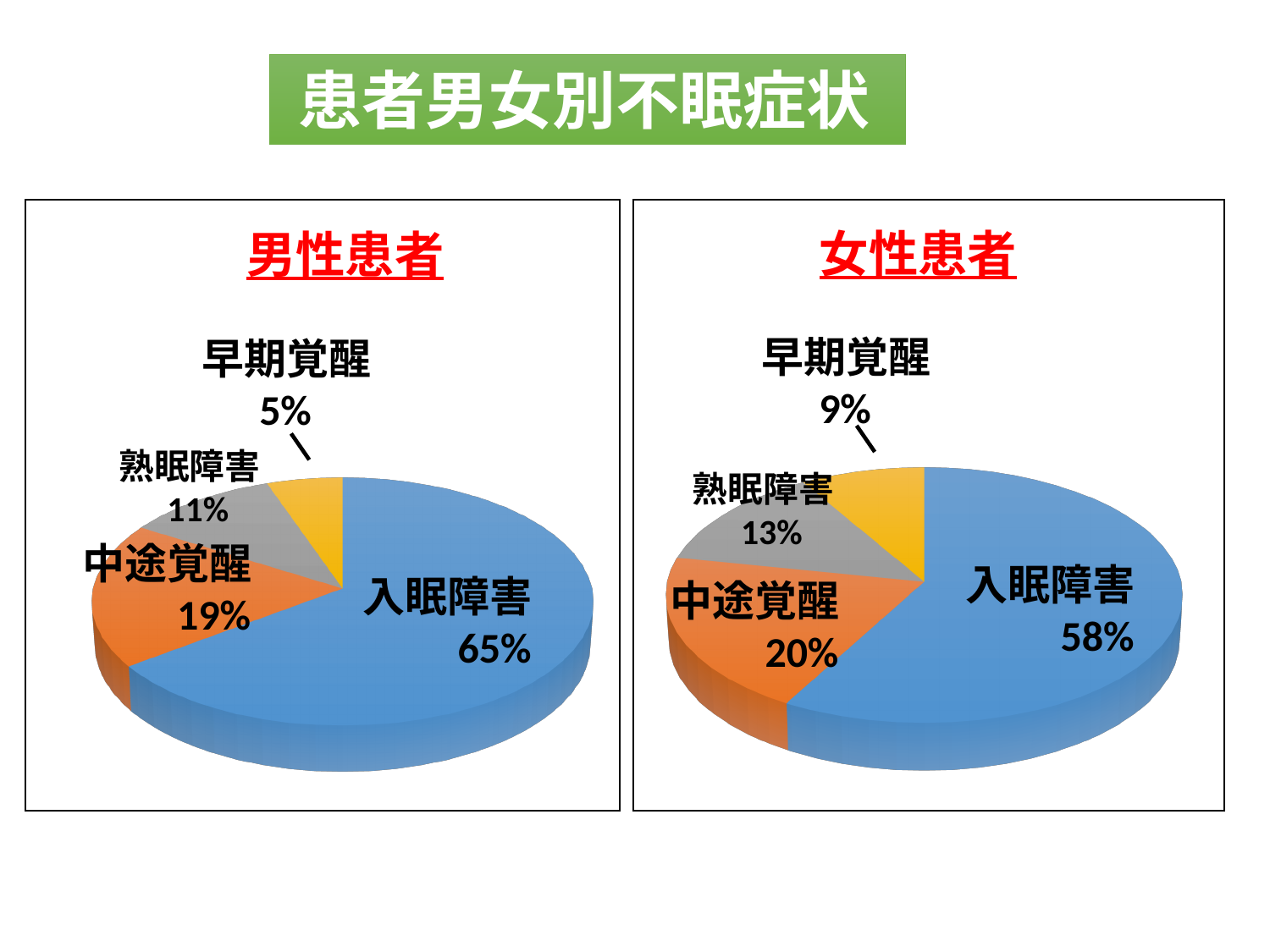
In the 女性患者 pie chart, which category has the largest slice? 入眠障害 In the 男性患者 pie chart, what is the share for 早期覚醒? 5% Which is larger: the share for 早期覚醒 in the 男性患者 chart or in the 女性患者 chart? 女性患者 In the 男性患者 pie chart, what is the share for 入眠障害? 65% In the 男性患者 pie chart, which category has the smallest slice? 早期覚醒 What is the title of the slide? 患者男女別不眠症状 What is the difference between the 入眠障害 share in the 男性患者 chart and in the 女性患者 chart? 7% What kind of chart is used for 男性患者? Pie chart In the 女性患者 pie chart, what is the share for 熟眠障害? 13% How many categories does the 女性患者 pie chart show? 4 In the 女性患者 pie chart, what is the share for 中途覚醒? 20% In the 男性患者 pie chart, what is the difference between the shares for 中途覚醒 and 熟眠障害? 8%